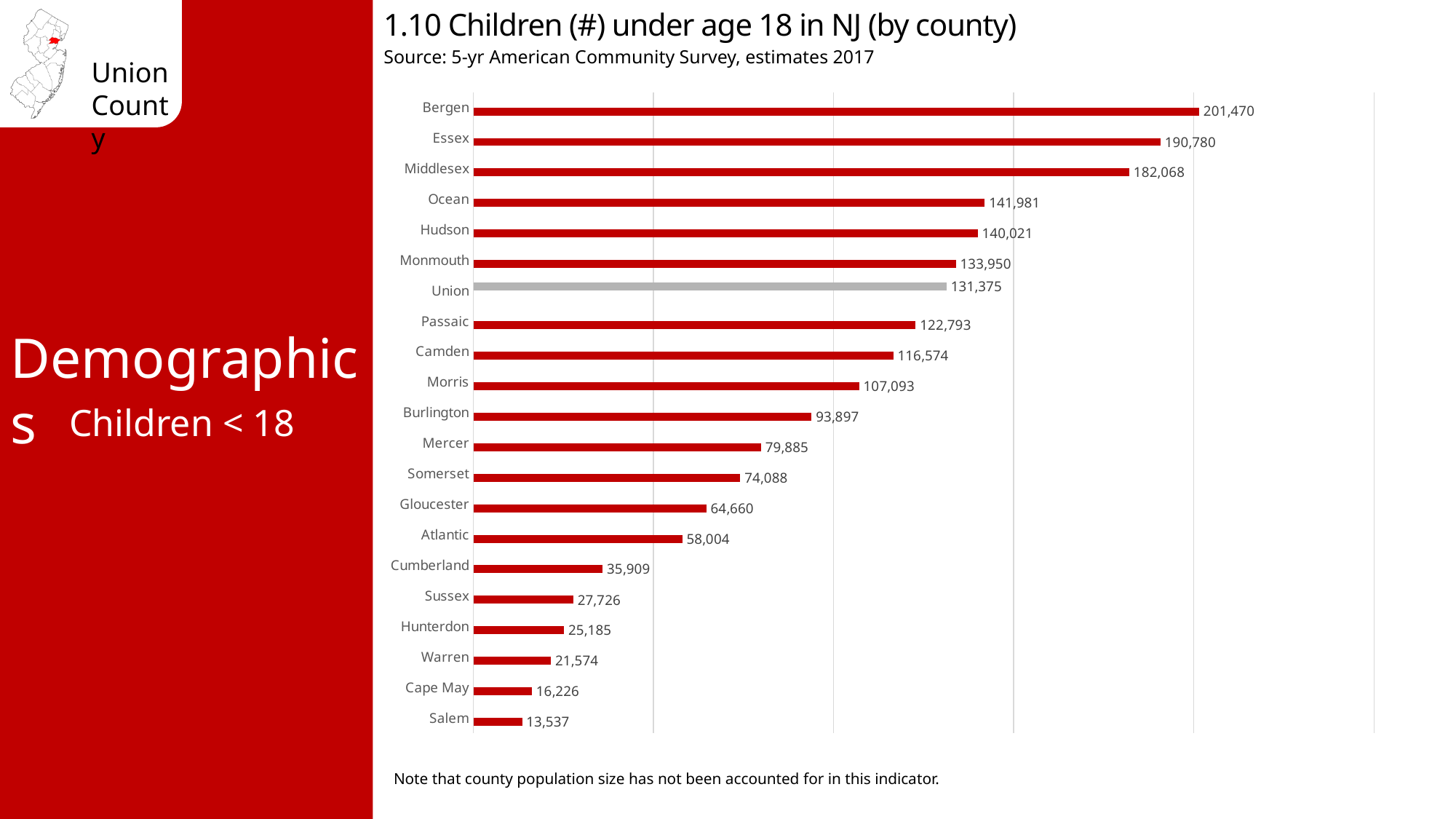
Which county has the lowest number of children under age 18? Salem What is the number of children under age 18 in Salem County? 13,537 Which county has the highest number of children under age 18? Bergen What type of chart is used on this slide? Bar chart Which county has more children under age 18, Morris or Camden? Camden How many counties are shown in the chart? 21 What is the difference between the number of children under 18 in Union and Passaic counties? 8,582 Which county's bar is shown in grey rather than red? Union What is the number of children under age 18 in Union County? 131,375 What is the difference between the number of children under 18 in Bergen and Essex counties? 10,690 Which county has more children under age 18, Sussex or Hunterdon? Sussex What is the number of children under age 18 in Ocean County? 141,981